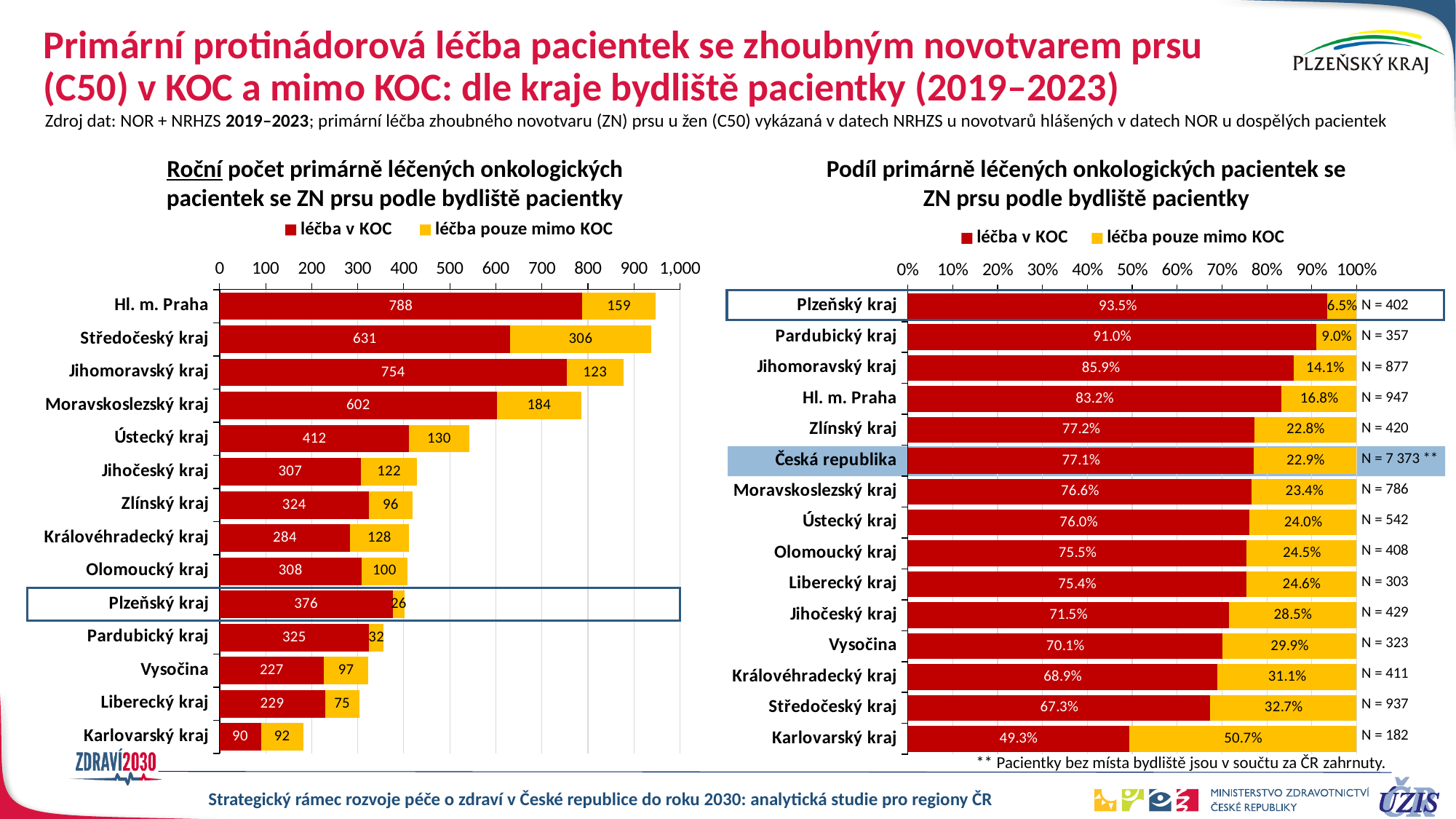
In the left chart (Roční počet primárně léčených onkologických pacientek), which region has the highest value for léčba v KOC? Hl. m. Praha In the right chart (Podíl primárně léčených onkologických pacientek), how many categories (bars) are shown? 15 How many series does the legend of the left chart (Roční počet primárně léčených onkologických pacientek) list? 2 In the left chart (Roční počet primárně léčených onkologických pacientek), which region has the lowest value for léčba v KOC? Karlovarský kraj In the left chart (Roční počet primárně léčených onkologických pacientek), what is the total of the stacked bar for Hl. m. Praha? 947 In the right chart (Podíl primárně léčených onkologických pacientek), what is the share of léčba v KOC for Karlovarský kraj? 49.3% In the left chart (Roční počet primárně léčených onkologických pacientek), what is the value of léčba v KOC for Plzeňský kraj? 376 In the left chart (Roční počet primárně léčených onkologických pacientek), what is the difference between léčba v KOC and léčba pouze mimo KOC for Jihomoravský kraj? 631 In the right chart (Podíl primárně léčených onkologických pacientek), what is the share of léčba pouze mimo KOC for Česká republika? 22.9% In the right chart (Podíl primárně léčených onkologických pacientek), which region has the highest share of léčba v KOC? Plzeňský kraj In the left chart (Roční počet primárně léčených onkologických pacientek), what is the value of léčba pouze mimo KOC for Středočeský kraj? 306 In the left chart (Roční počet primárně léčených onkologických pacientek), which is larger for léčba v KOC: Ústecký kraj or Olomoucký kraj? Ústecký kraj